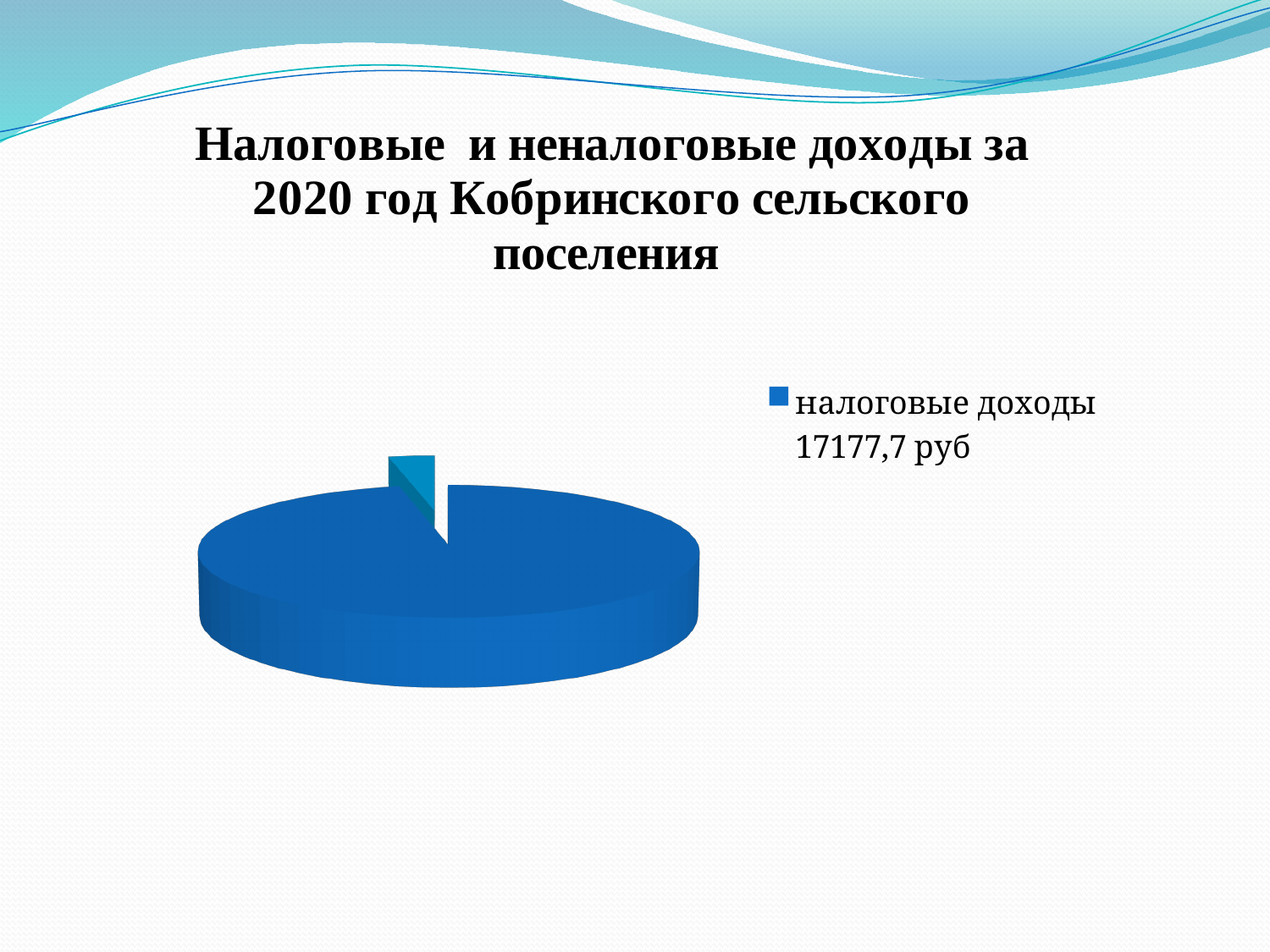
What value is given for налоговые доходы in the chart legend? 17177,7 руб Which year does the chart title refer to? 2020 How many slices does the pie chart have? 2 Which category takes up the largest share of the pie chart? налоговые доходы How many entries does the chart legend list? 1 What colour is the slice for налоговые доходы? blue What kind of chart is shown on the slide? pie chart What is the title of the chart slide? Налоговые и неналоговые доходы за 2020 год Кобринского сельского поселения